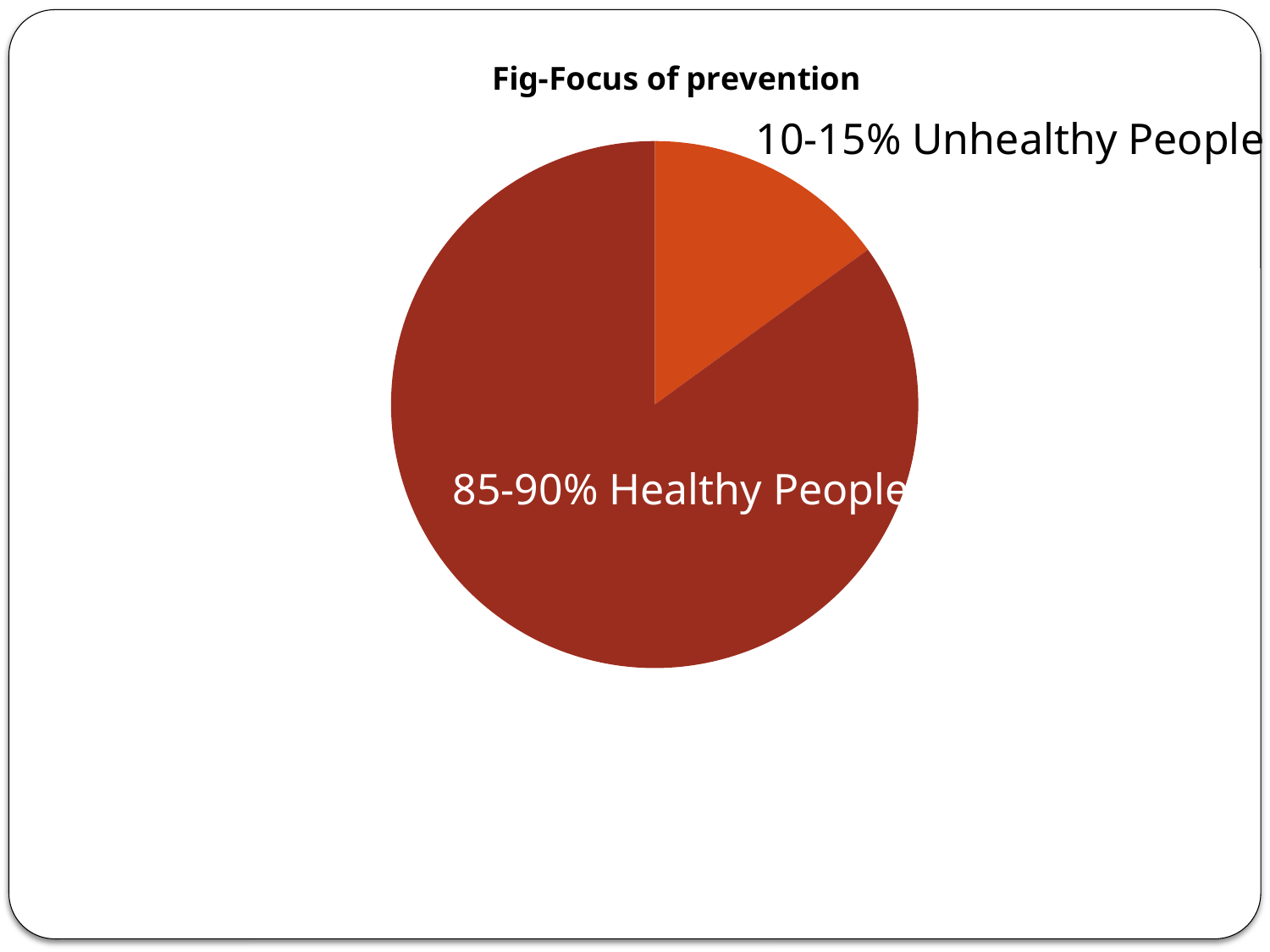
How many slices does the pie chart have? 2 What kind of chart is shown on the slide? pie chart Which slice is the smallest in the pie chart? 10-15% Unhealthy People What is the title of the chart? Fig-Focus of prevention What colour is the Unhealthy People slice? orange What share of the pie is labelled as Healthy People? 85-90% Which slice is larger, Healthy People or Unhealthy People? Healthy People What share of the pie is labelled as Unhealthy People? 10-15% Which slice is the largest in the pie chart? 85-90% Healthy People